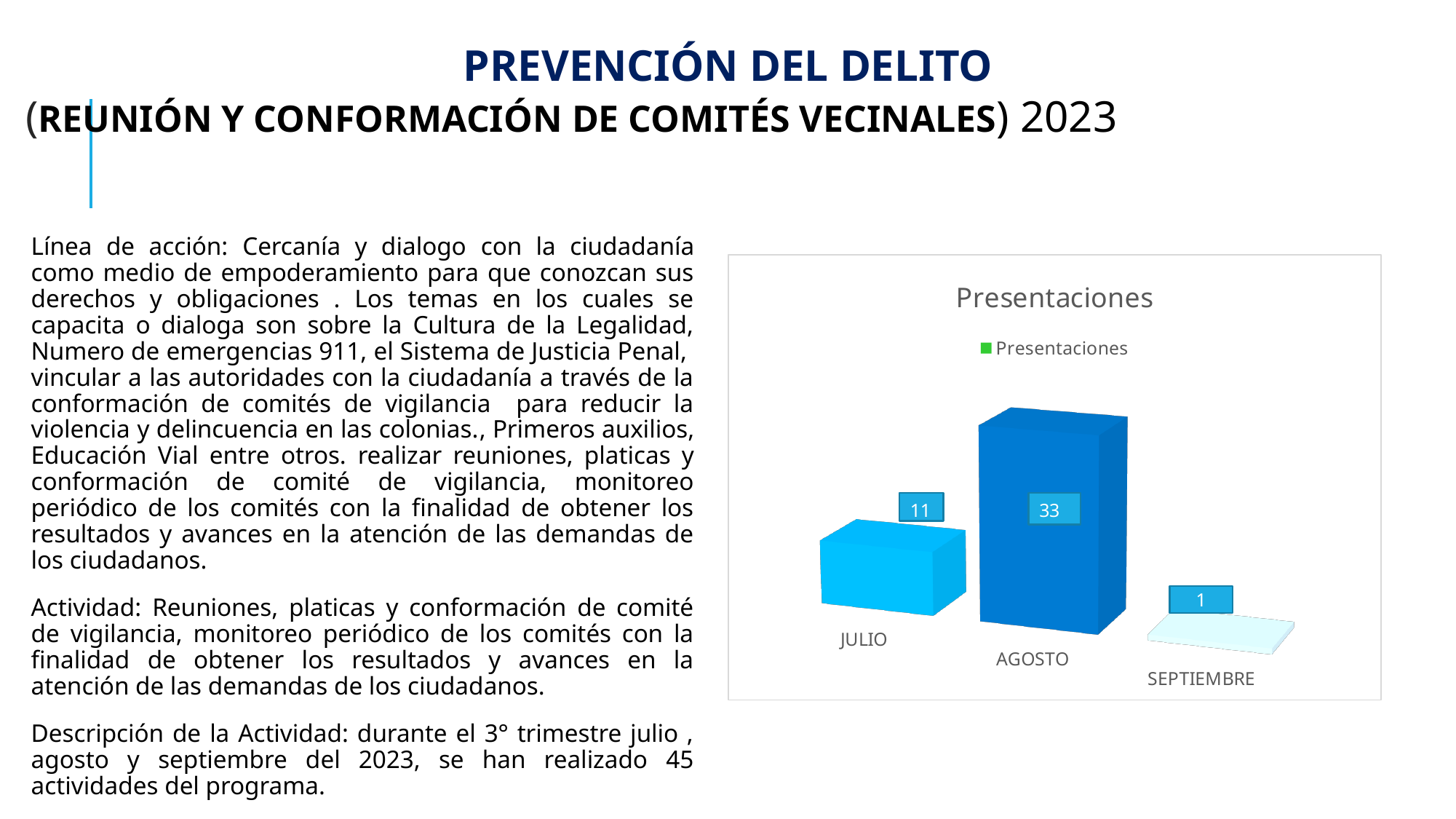
How many series does the legend of the Presentaciones chart list? 1 Which month has the lowest value in the Presentaciones chart? SEPTIEMBRE Which is larger in the Presentaciones chart, the value for JULIO or the value for SEPTIEMBRE? JULIO What is the difference between the values for AGOSTO and JULIO in the Presentaciones chart? 22 What is the value for SEPTIEMBRE in the Presentaciones chart? 1 What is the title of the chart on the slide? Presentaciones What is the value for AGOSTO in the Presentaciones chart? 33 Which month has the highest value in the Presentaciones chart? AGOSTO What is the difference between the values for JULIO and SEPTIEMBRE in the Presentaciones chart? 10 How many months are shown in the Presentaciones chart? 3 What is the value for JULIO in the Presentaciones chart? 11 What kind of chart is the Presentaciones chart? bar chart